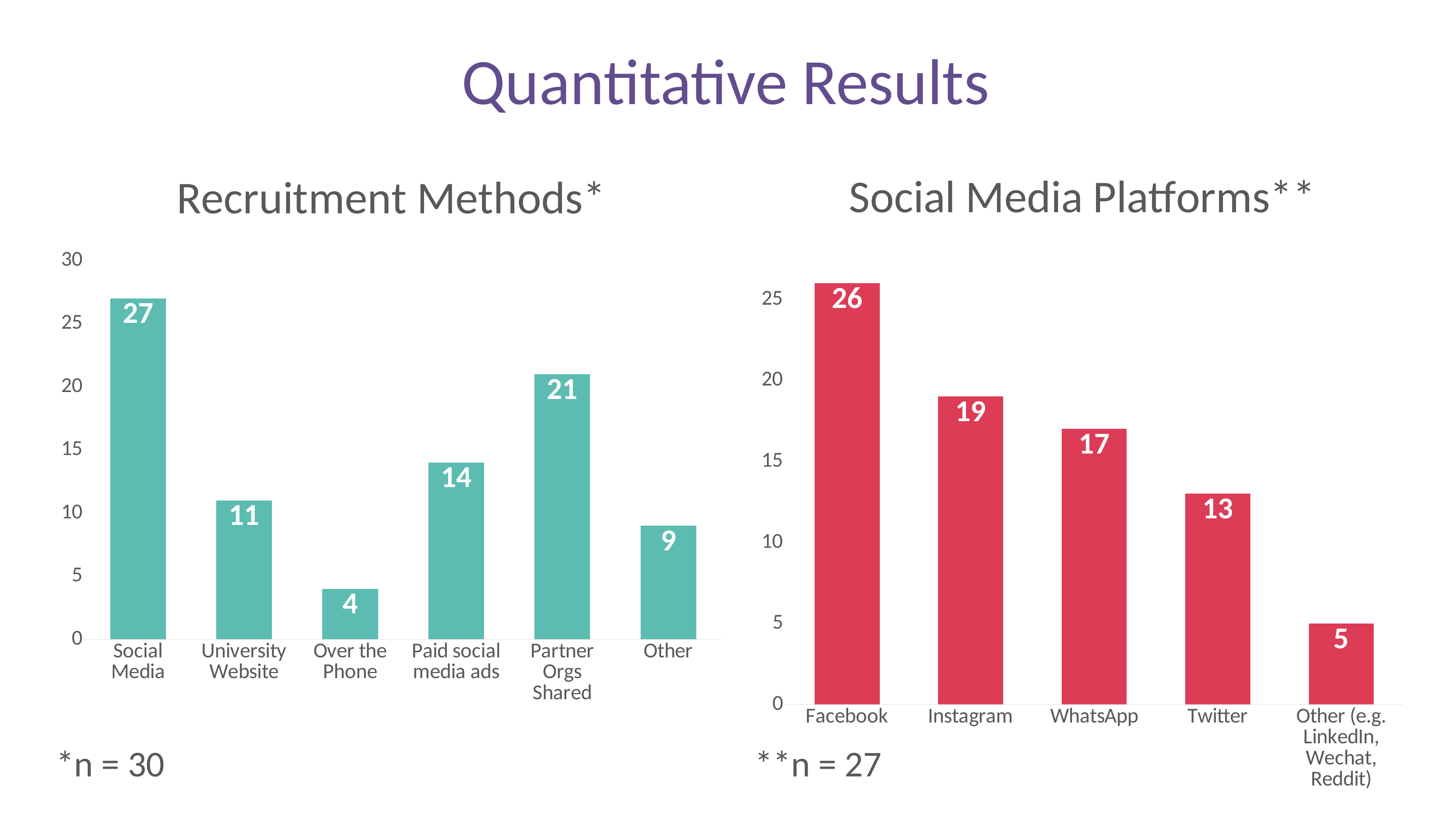
What colour are the bars in the Recruitment Methods chart? teal In the Social Media Platforms chart, do the values rise or fall from left to right? fall In the Recruitment Methods chart, what is the difference between Social Media and Partner Orgs Shared? 6 In the Recruitment Methods chart, what is the value for Social Media? 27 In the Recruitment Methods chart, how many categories are shown? 6 What kind of chart is the Social Media Platforms chart? bar chart In the Recruitment Methods chart, which category has the lowest value? Over the Phone In the Social Media Platforms chart, what is the value for WhatsApp? 17 In the Social Media Platforms chart, what is the difference between Instagram and Twitter? 6 In the Recruitment Methods chart, which is larger, University Website or Paid social media ads? Paid social media ads In the Social Media Platforms chart, which platform has the highest value? Facebook In the Recruitment Methods chart, what is the value for Over the Phone? 4